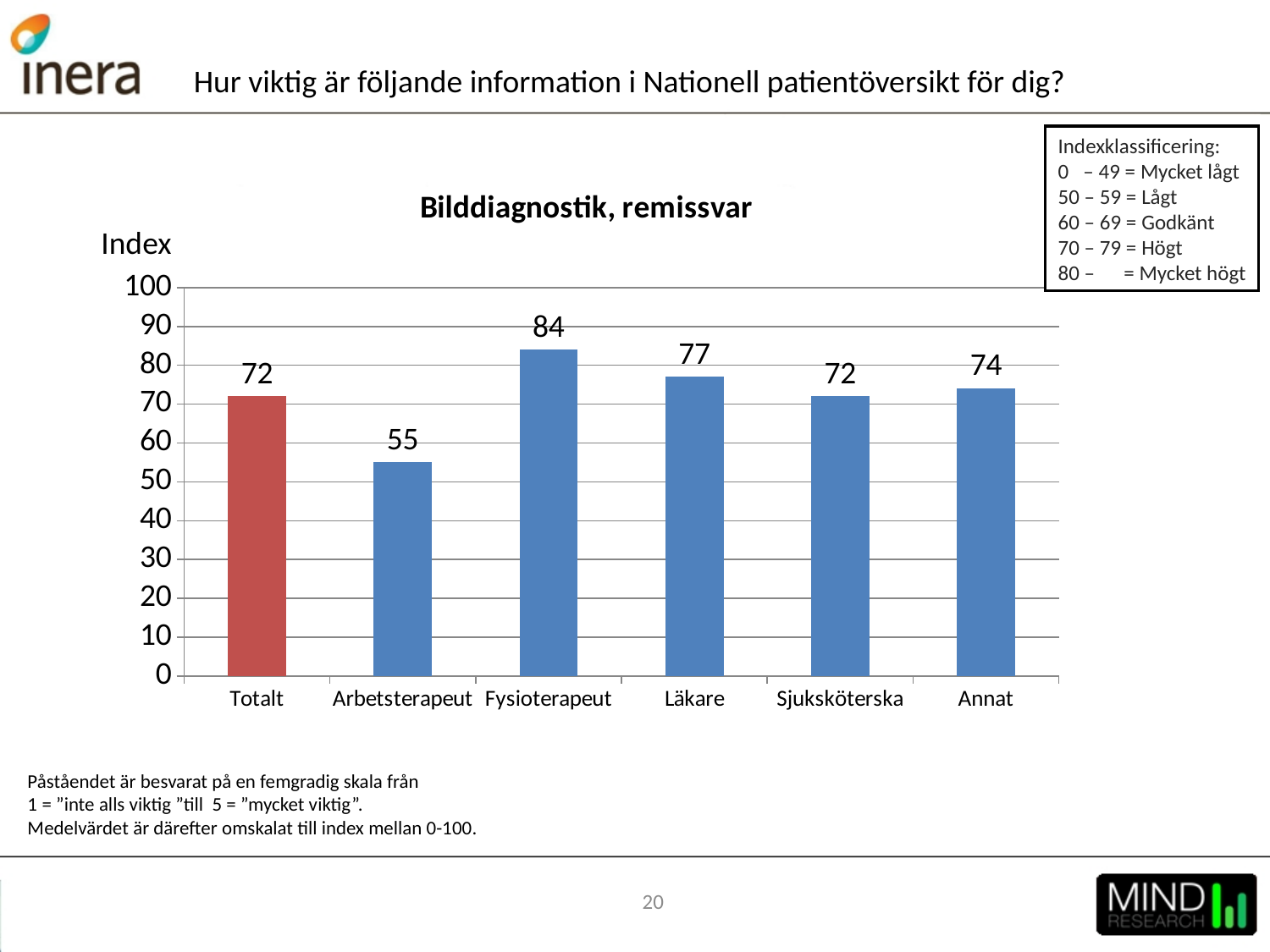
Is the value for Sjuksköterska greater or less than 60? greater What is the index value for Arbetsterapeut? 55 What is the index value for Fysioterapeut? 84 Which bar is coloured differently (red) from the others? Totalt What is the difference between the index values for Fysioterapeut and Arbetsterapeut? 29 How many categories are shown on the x axis? 6 Which category has the lowest index value? Arbetsterapeut What kind of chart is shown on the slide? bar chart Which category has the highest index value? Fysioterapeut What is the title of the chart? Bilddiagnostik, remissvar Which has a higher index value, Läkare or Annat? Läkare What is the index value for Läkare? 77